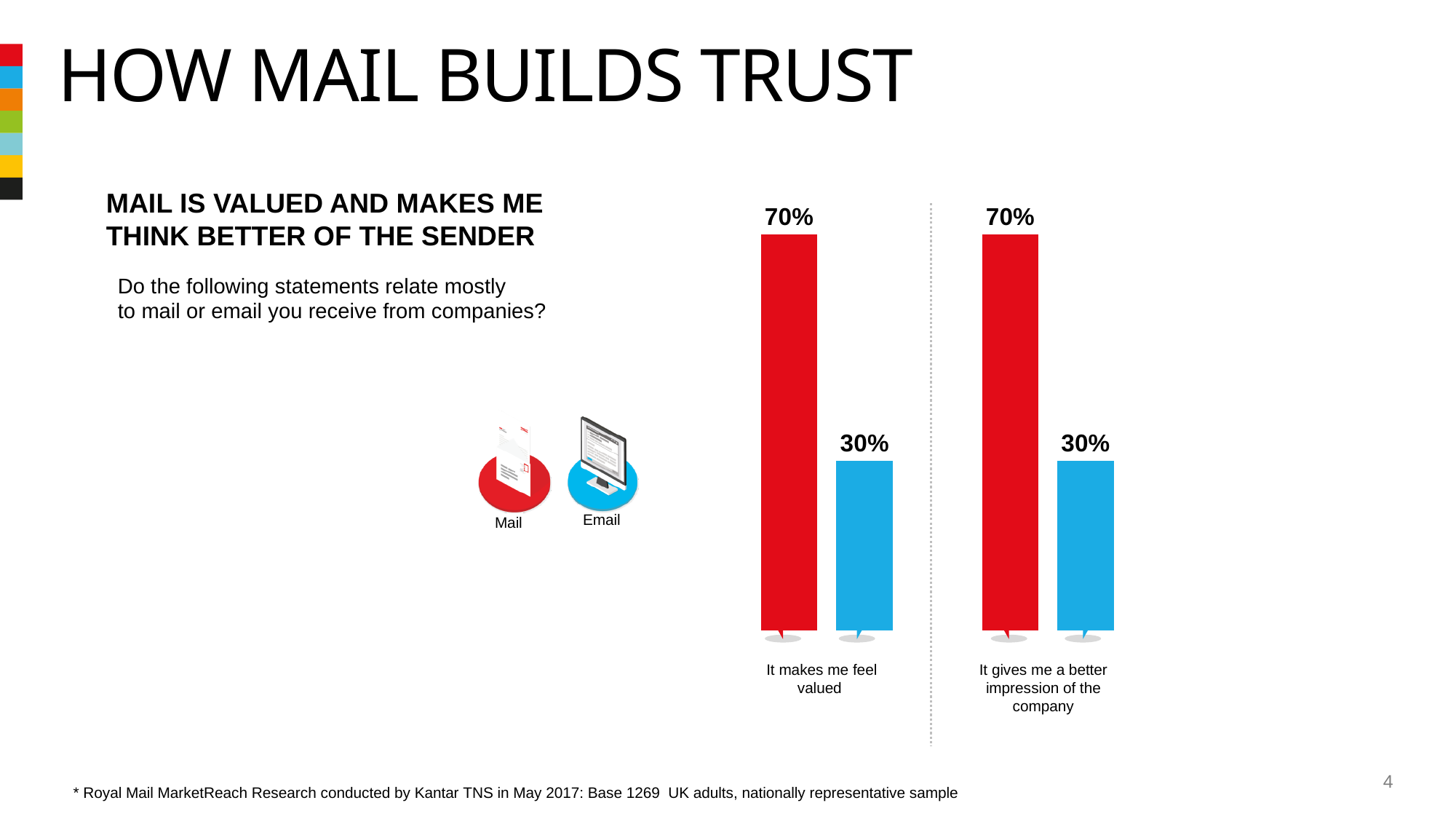
Which colour represents email in the chart? Blue For "It gives me a better impression of the company", what is the difference between the mail value and the email value? 40% How many series does the chart compare? 2 How many statements (categories) are shown in the chart? 2 What percentage of respondents said "It makes me feel valued" relates mostly to email? 30% Which colour represents mail in the chart? Red For "It makes me feel valued", which is larger: the value for mail or the value for email? Mail What percentage of respondents said "It makes me feel valued" relates mostly to mail? 70% What kind of chart is shown on the slide? Bar chart What percentage of respondents said "It gives me a better impression of the company" relates mostly to mail? 70% For "It makes me feel valued", what is the difference between the mail value and the email value? 40% What percentage of respondents said "It gives me a better impression of the company" relates mostly to email? 30%